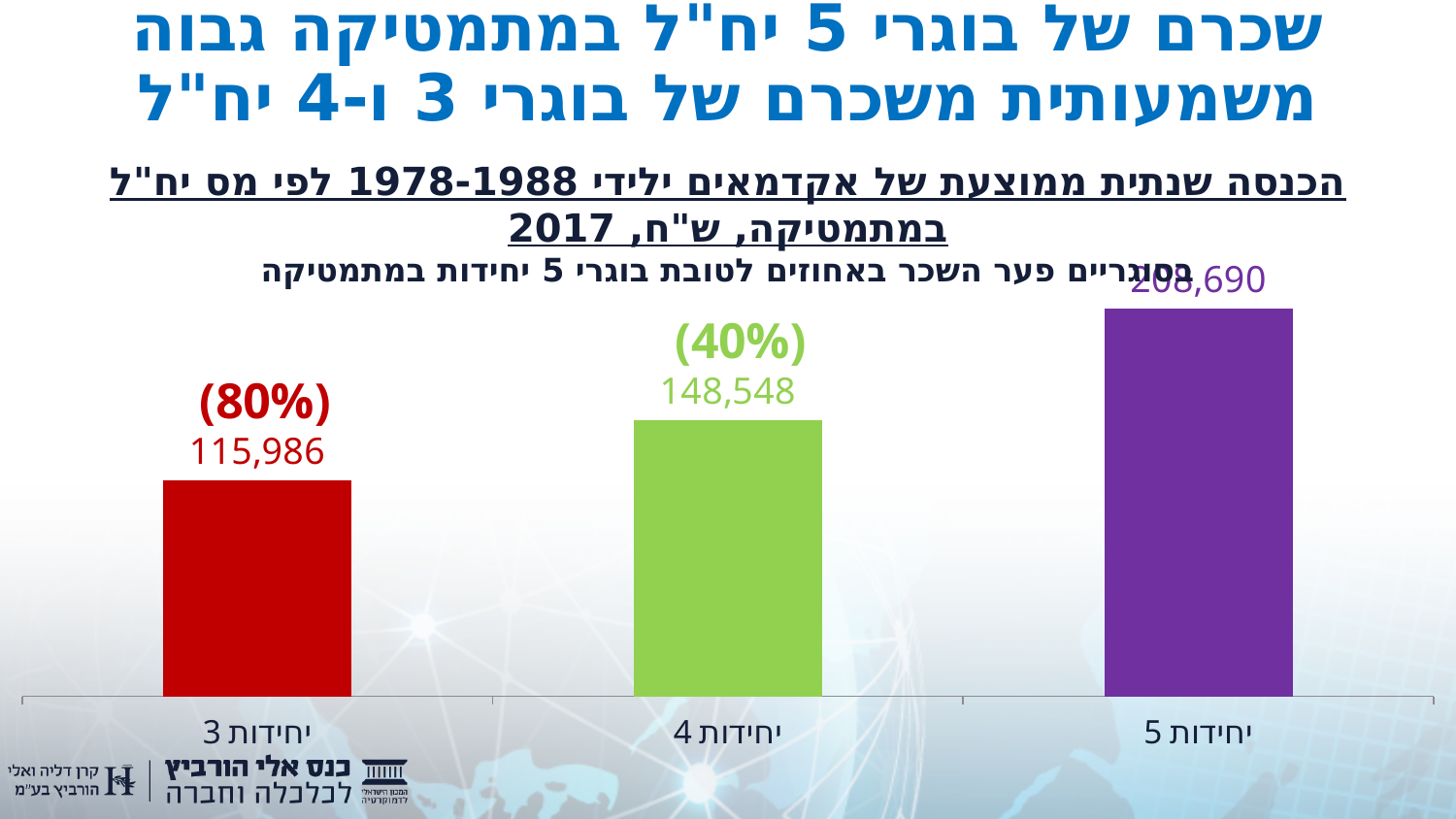
Which category has the highest bar? 5 יחידות What kind of chart is shown on the slide? Bar chart What is the difference between the values for 4 יחידות and 3 יחידות? 32,562 What percentage is printed in parentheses above the 3 יחידות bar? (80%) What is the value shown for the 5 יחידות bar? 208,690 What is the value shown for the 4 יחידות bar? 148,548 Which category has the lowest bar? 3 יחידות How many categories are shown on the x axis? 3 Which is larger, the value for 4 יחידות or the value for 3 יחידות? 4 יחידות Do the values rise or fall from left to right along the x axis? Rise What is the value shown for the 3 יחידות bar? 115,986 What is the difference between the values for 5 יחידות and 4 יחידות? 60,142